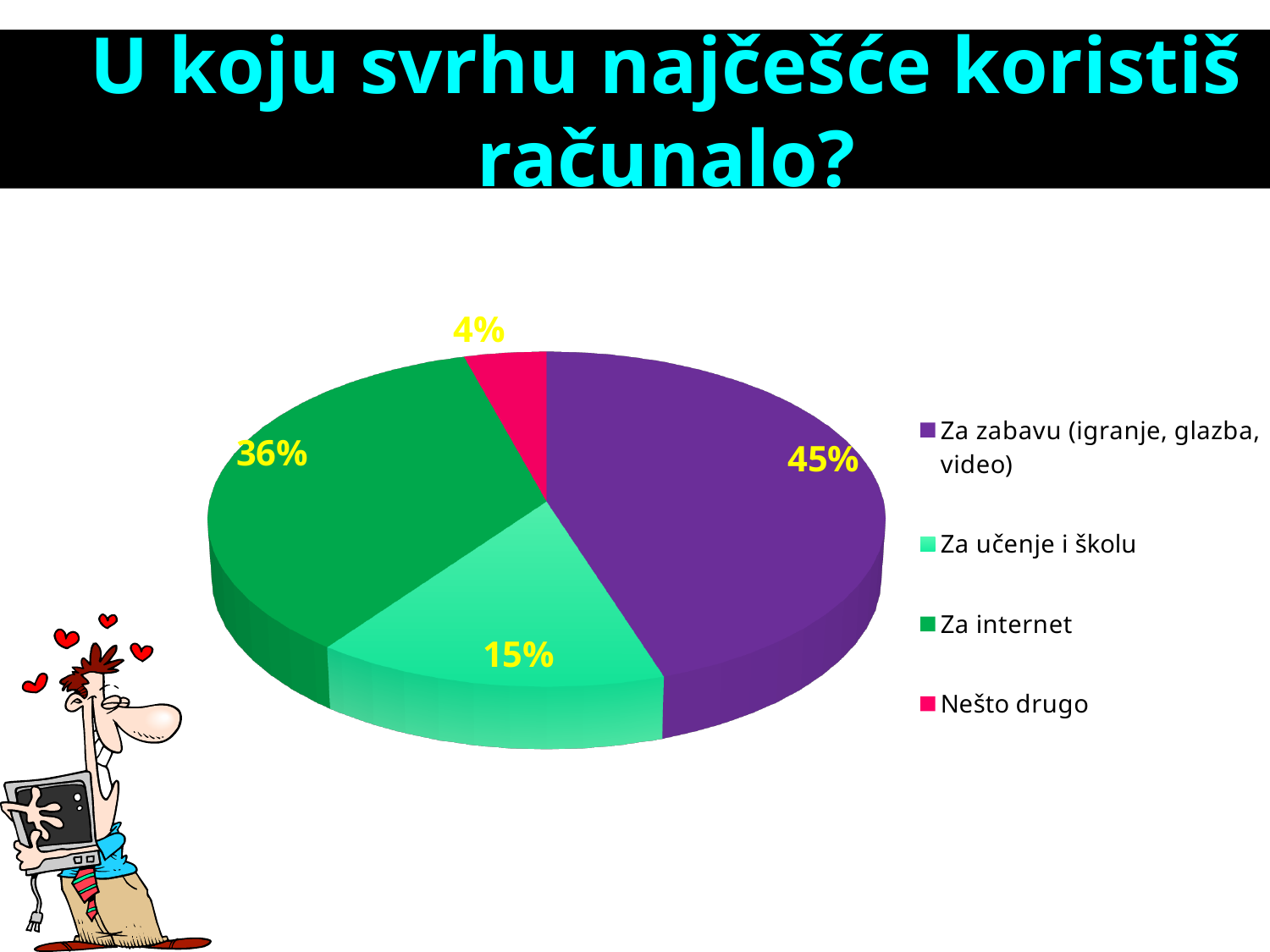
What kind of chart is shown on the slide? Pie chart What is the value shown for "Za učenje i školu"? 15% Which is larger, the slice for "Za internet" or the slice for "Za učenje i školu"? Za internet Which category has the smallest slice of the pie? Nešto drugo What colour is the slice for "Nešto drugo"? Pink What is the value shown for "Za internet"? 36% What is the title of the slide containing the chart? U koju svrhu najčešće koristiš računalo? What is the difference in percentage points between "Za zabavu (igranje, glazba, video)" and "Za internet"? 9% What share of the pie does "Za zabavu (igranje, glazba, video)" represent? 45% What is the value shown for "Nešto drugo"? 4% Which category has the largest slice of the pie? Za zabavu (igranje, glazba, video) How many categories does the pie chart show? 4